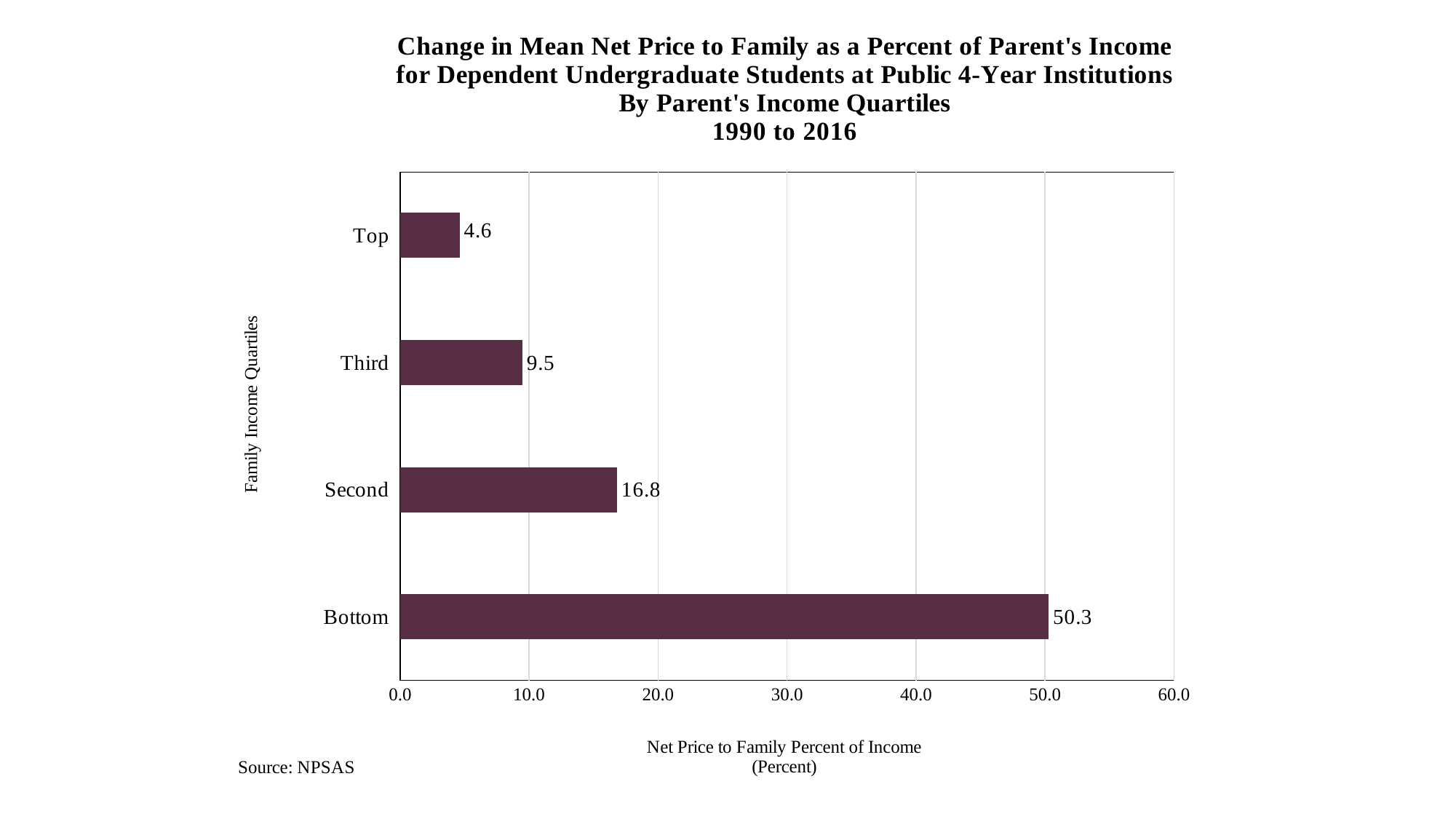
How many quartile categories are shown in the chart? 4 What kind of chart is shown on the slide? Bar chart Is the value for Bottom greater or less than 40.0? greater What is the value for the Bottom quartile? 50.3 What is the value for the Top quartile? 4.6 Which quartile has the highest value? Bottom Which quartile has the lowest value? Top What is the difference between the values for the Bottom and Second quartiles? 33.5 Which is larger, the value for Second or the value for Third? Second What is the value for the Third quartile? 9.5 What is the value for the Second quartile? 16.8 What is the difference between the values for the Third and Top quartiles? 4.9